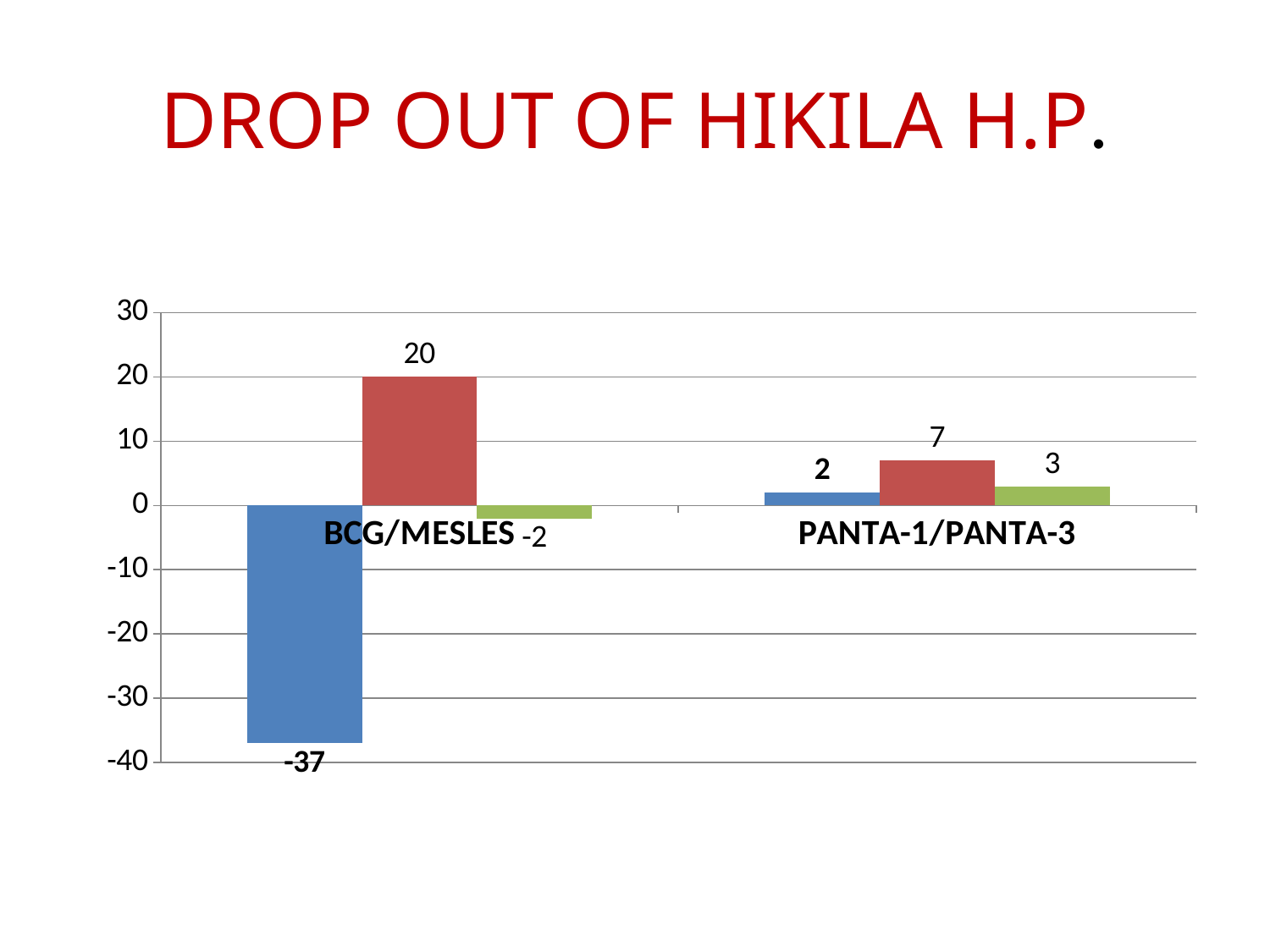
Which bar has the highest value in the chart? The red bar for BCG/MESLES (20) Which is larger: the green bar for PANTA-1/PANTA-3 or the blue bar for PANTA-1/PANTA-3? The green bar (3) What is the value of the green bar for BCG/MESLES? -2 What is the value of the red bar for BCG/MESLES? 20 What is the difference between the red bar values for BCG/MESLES and PANTA-1/PANTA-3? 13 What is the value of the green bar for PANTA-1/PANTA-3? 3 What is the value of the red bar for PANTA-1/PANTA-3? 7 What is the value of the blue bar for PANTA-1/PANTA-3? 2 Which bar has the lowest value in the chart? The blue bar for BCG/MESLES (-37) How many categories are shown on the x axis? 2 What type of chart is shown on the slide? Bar chart What is the value of the blue bar for BCG/MESLES? -37